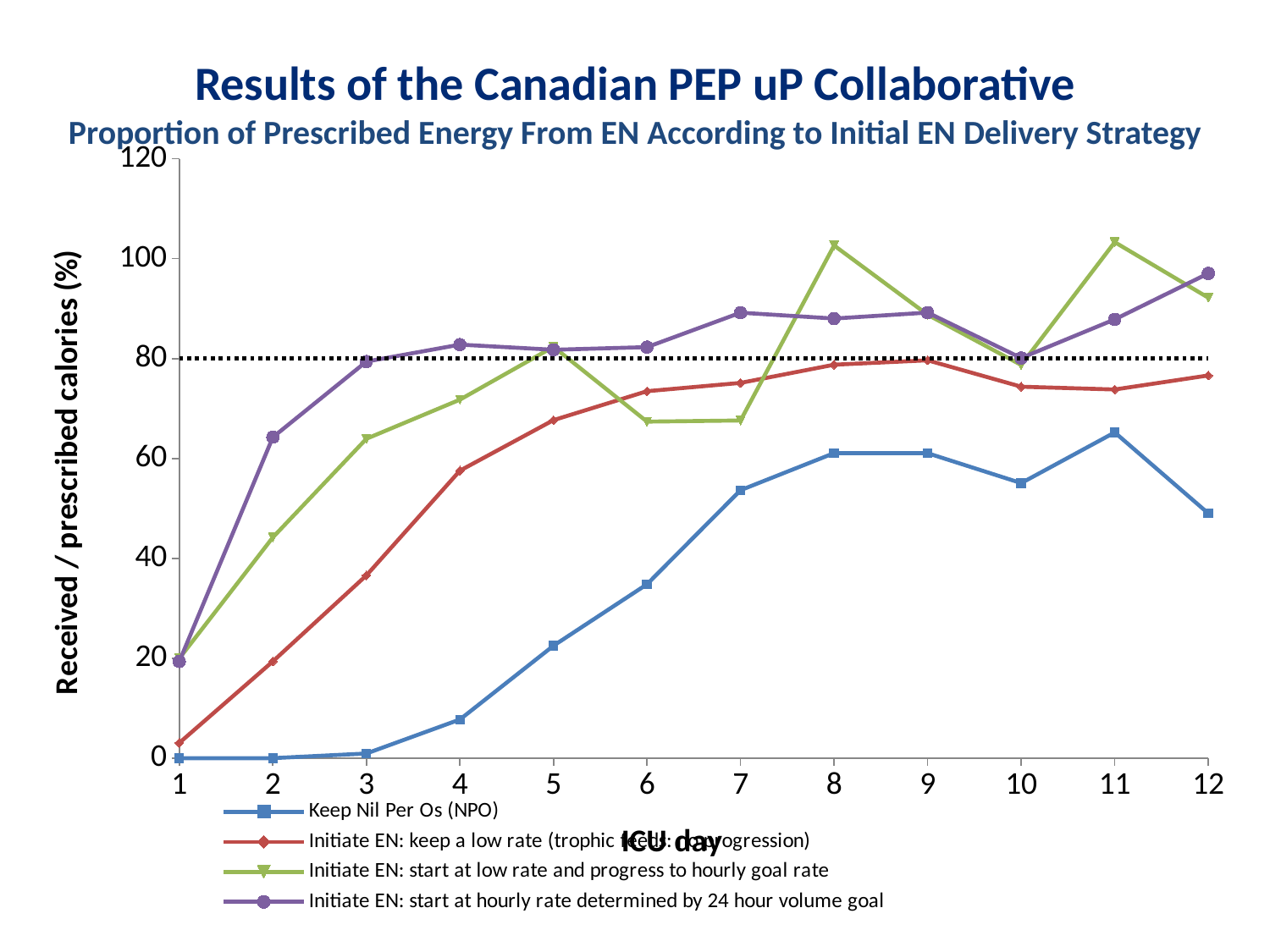
How many series does the legend list? 4 Is the value for 'Initiate EN: start at low rate and progress to hourly goal rate' on ICU day 8 greater or less than 100? greater Is the value for Keep Nil Per Os (NPO) on ICU day 8 greater or less than 40? greater Which series has the lowest value on ICU day 6? Keep Nil Per Os (NPO) Which series has the highest value on ICU day 8? Initiate EN: start at low rate and progress to hourly goal rate At what value on the y axis is the horizontal dotted reference line drawn? 80 What is the value for Keep Nil Per Os (NPO) on ICU day 1? 0 What kind of chart is shown on the slide? line chart Is the value for 'Initiate EN: start at hourly rate determined by 24 hour volume goal' on ICU day 2 greater or less than 40? greater On ICU day 11, which is larger: the value for 'Initiate EN: start at low rate and progress to hourly goal rate' or the value for 'Initiate EN: start at hourly rate determined by 24 hour volume goal'? Initiate EN: start at low rate and progress to hourly goal rate How many ICU days are plotted along the x axis? 12